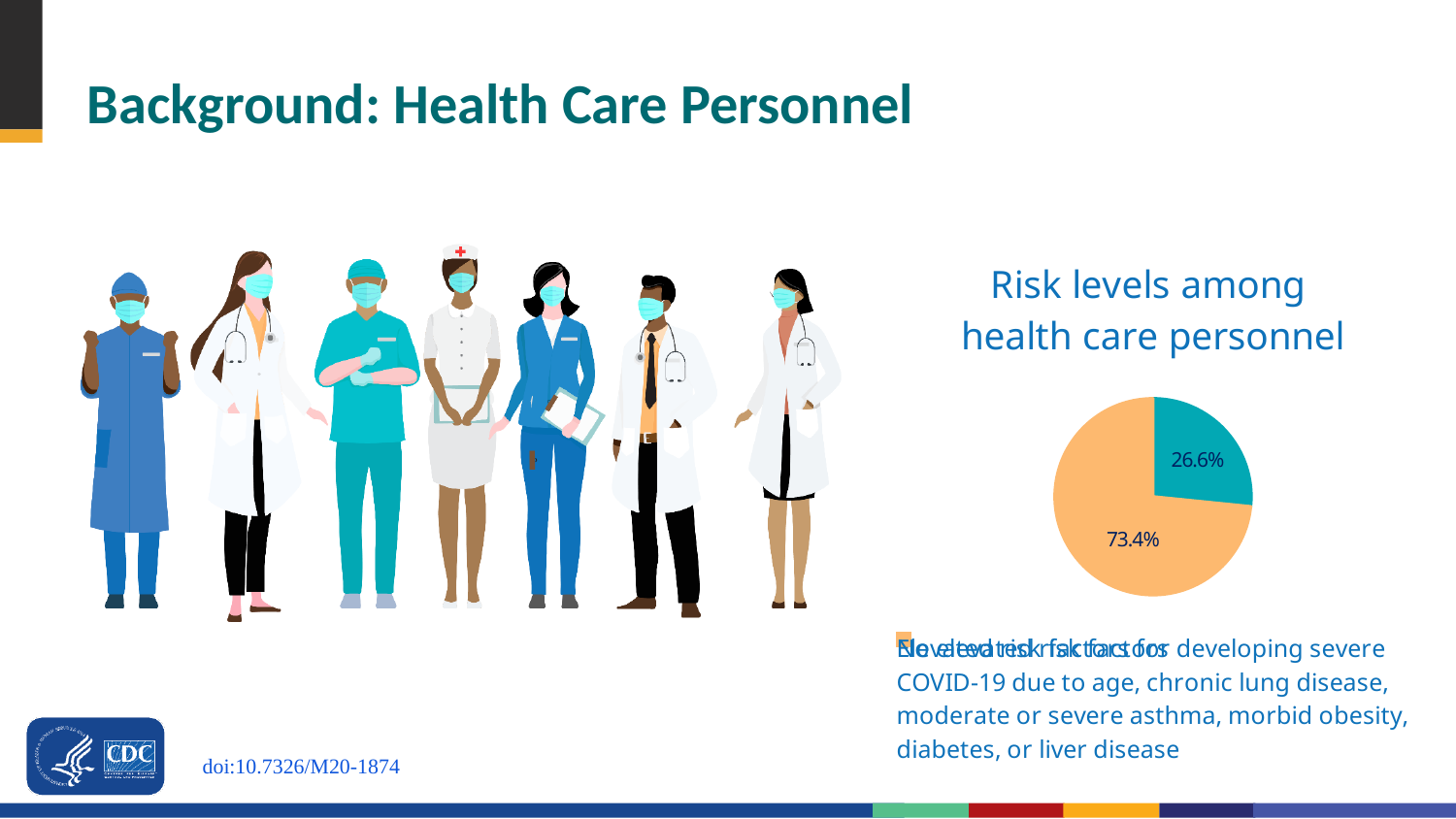
What do the two slices of the pie chart add up to? 100% How many slices does the pie chart have? 2 What value is labelled on the teal slice of the pie chart? 26.6% What is the difference between the two slices of the pie chart, in percentage points? 46.8 Which slice of the pie chart is larger, the orange one or the teal one? orange What is the smallest value shown in the pie chart? 26.6% Is the value of the teal slice greater or less than 30%? less What kind of chart is shown on the slide? pie chart What value is labelled on the orange slice of the pie chart? 73.4% What is the title of the pie chart? Risk levels among health care personnel What is the largest value shown in the pie chart? 73.4% Is the value of the orange slice greater or less than 50%? greater